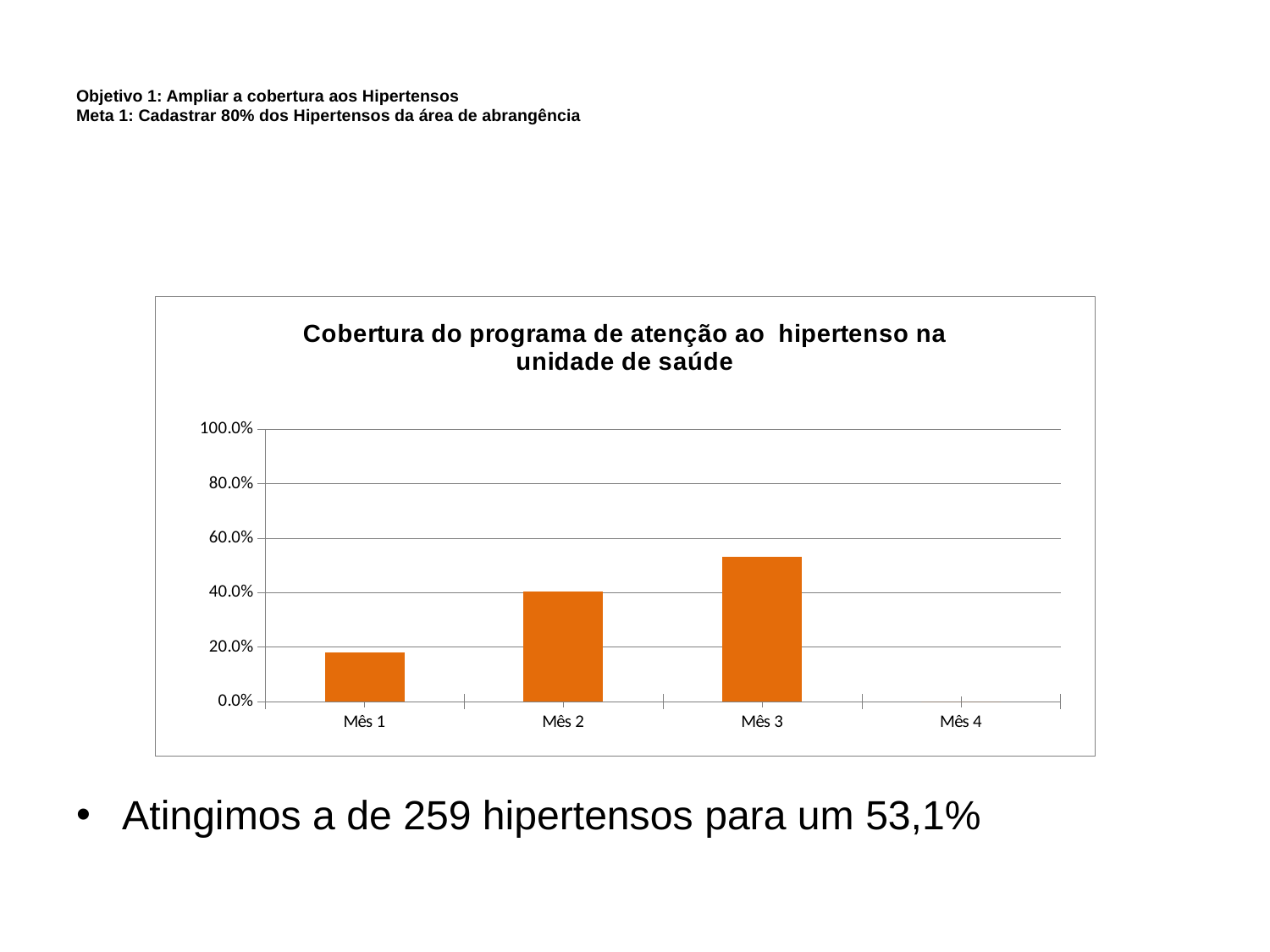
Which of Mês 1 and Mês 2 has the larger value? Mês 2 Is the value for Mês 3 greater or less than 40.0%? greater Do the values rise or fall from Mês 1 to Mês 3? rise How many categories are shown on the x axis of the chart? 4 Which month on the x axis has no bar plotted? Mês 4 Which of Mês 2 and Mês 3 has the larger value? Mês 3 Is the value for Mês 3 greater or less than 60.0%? less Is the value for Mês 2 greater or less than 20.0%? greater What is the title of the chart? Cobertura do programa de atenção ao hipertenso na unidade de saúde Which month has the highest coverage value in the chart? Mês 3 What kind of chart is shown on the slide? bar chart